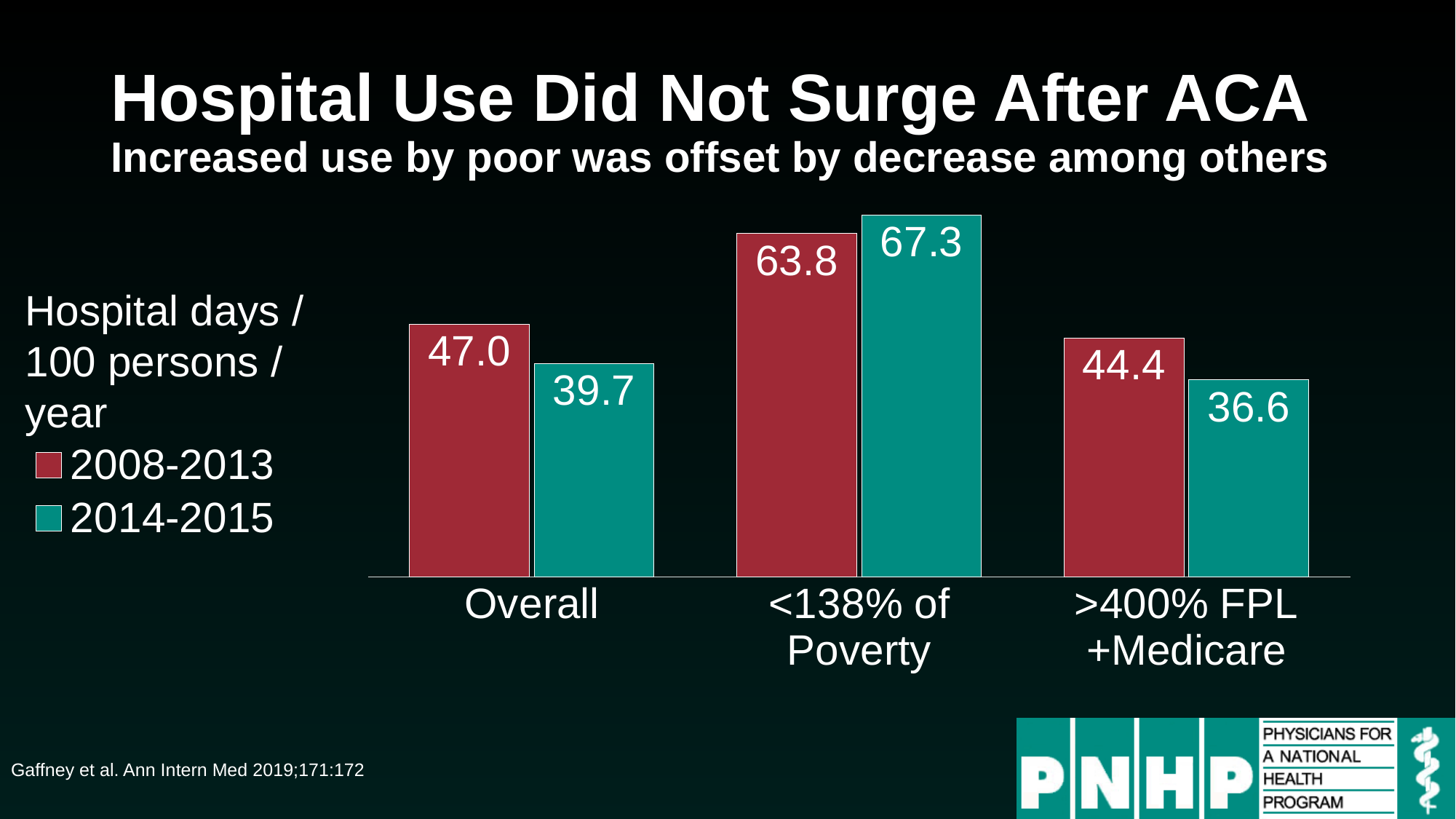
Which category has the highest value in the 2008-2013 series? <138% of Poverty What is the value for >400% FPL +Medicare in the 2014-2015 series? 36.6 What kind of chart is shown on the slide? bar chart What is the difference between the 2014-2015 and 2008-2013 values for <138% of Poverty? 3.5 For >400% FPL +Medicare, which series has the larger value, 2008-2013 or 2014-2015? 2008-2013 How many series does the legend list? 2 What is the difference between the 2008-2013 and 2014-2015 values for Overall? 7.3 Which category has the lowest value in the 2014-2015 series? >400% FPL +Medicare How many categories are shown on the x axis? 3 What unit is the chart's y axis measured in, according to the label on the left? Hospital days / 100 persons / year What is the value for <138% of Poverty in the 2014-2015 series? 67.3 What is the value for Overall in the 2008-2013 series? 47.0